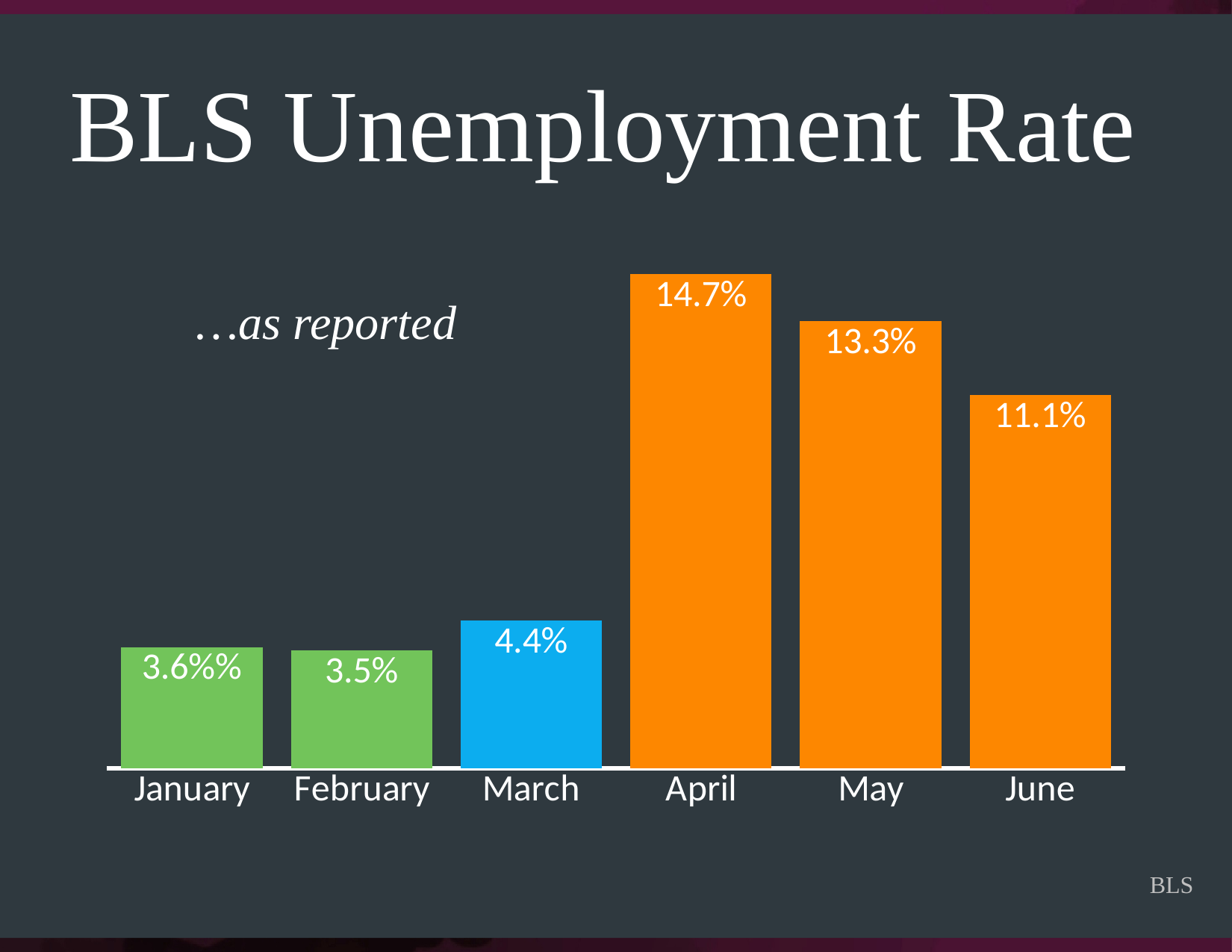
How many months are plotted in the chart? 6 What is the difference between the May and June unemployment rates? 2.2% What is the unemployment rate shown for March? 4.4% What kind of chart is shown on the slide? Bar chart Which month has the lowest unemployment rate? February Which is larger, the rate for March or the rate for February? March What is the unemployment rate shown for April? 14.7% What is the unemployment rate shown for June? 11.1% Do the values rise or fall from April to June? Fall Which month has the highest unemployment rate? April How much higher is the April rate than the May rate? 1.4% What is the unemployment rate shown for February? 3.5%